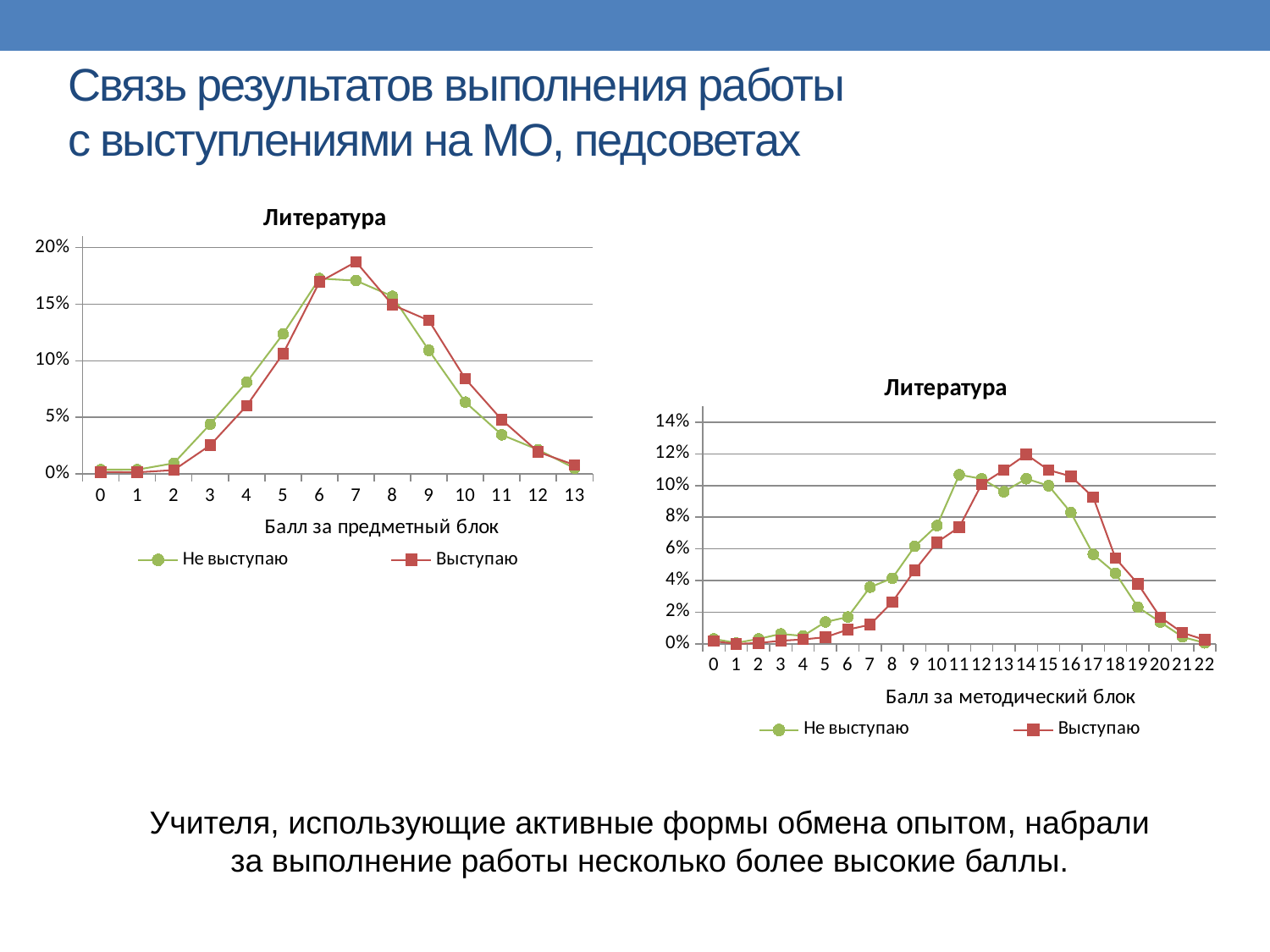
What type of chart is the left chart (Балл за предметный блок)? line chart In the left chart (Балл за предметный блок), is the value for Выступаю at score 10 greater or less than 10%? less In the left chart (Балл за предметный блок), at which score does the Выступаю series reach its highest value? 7 In the left chart (Балл за предметный блок), which series has the higher value at score 4? Не выступаю How many score values are plotted along the x axis of the right chart (Балл за методический блок)? 23 In the right chart (Балл за методический блок), at which score does the Выступаю series reach its highest value? 14 In the right chart (Балл за методический блок), is the value for Выступаю at score 14 greater or less than 10%? greater In the right chart (Балл за методический блок), which series has the higher value at score 16? Выступаю How many score values are plotted along the x axis of the left chart (Балл за предметный блок)? 14 In the left chart (Балл за предметный блок), is the value for Выступаю at score 7 greater or less than 15%? greater What is the x-axis title of the right chart? Балл за методический блок How many series does the legend of the right chart (Балл за методический блок) list? 2